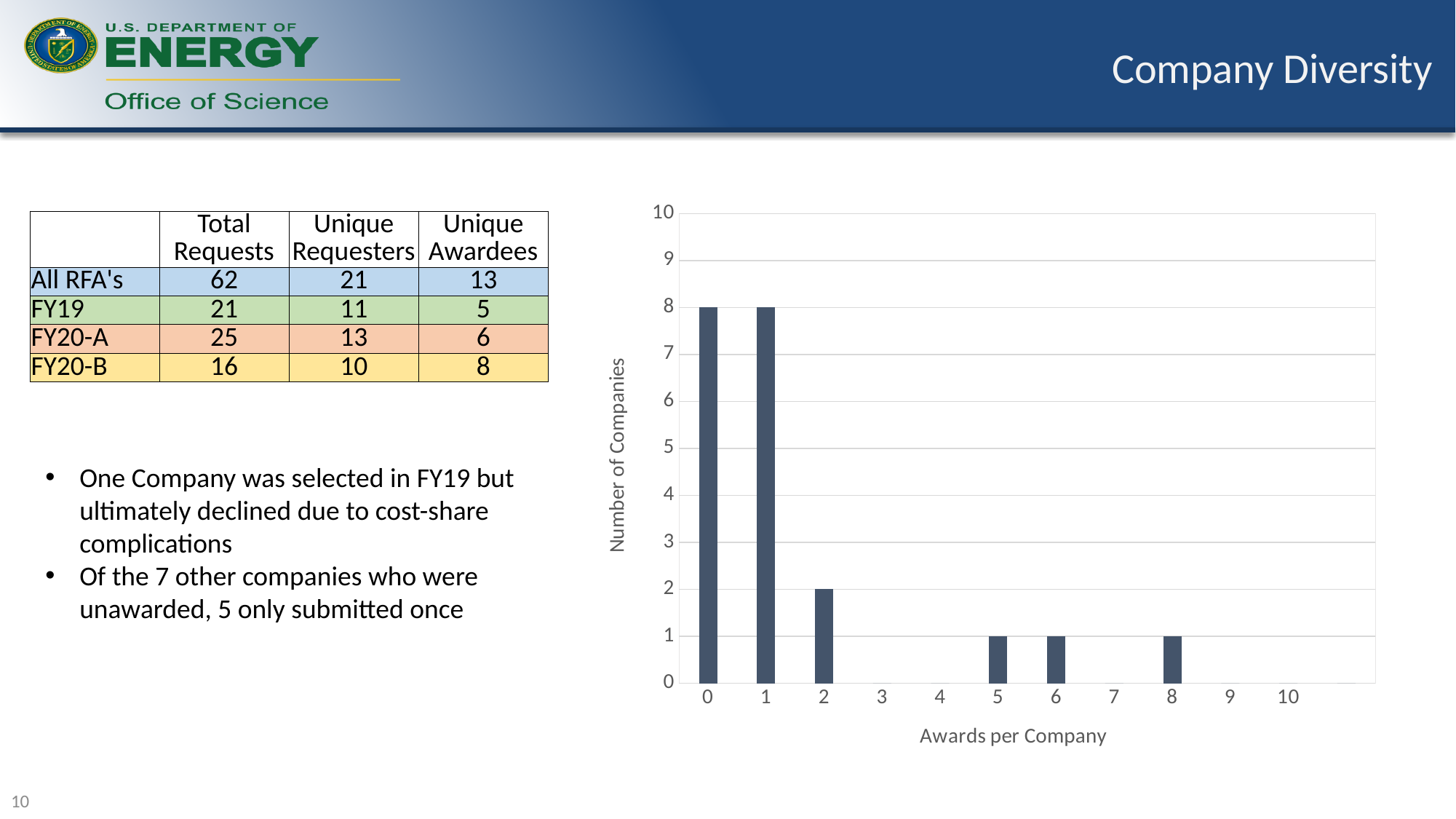
What kind of chart is shown on the slide? bar chart Is the number of companies with 2 awards per company greater or less than 5? less What is the number of companies with 5 awards per company? 1 What is the number of companies with 2 awards per company? 2 How many categories are shown on the x axis of the chart? 11 What is the difference between the number of companies with 0 awards and the number with 2 awards? 6 What is the title of the chart's y axis? Number of Companies Which is larger, the number of companies with 1 award or with 2 awards? 1 award What is the number of companies with 0 awards per company? 8 Do the bar heights generally rise or fall as awards per company increases? fall Is the number of companies with 1 award per company greater or less than 5? greater What is the number of companies with 8 awards per company? 1